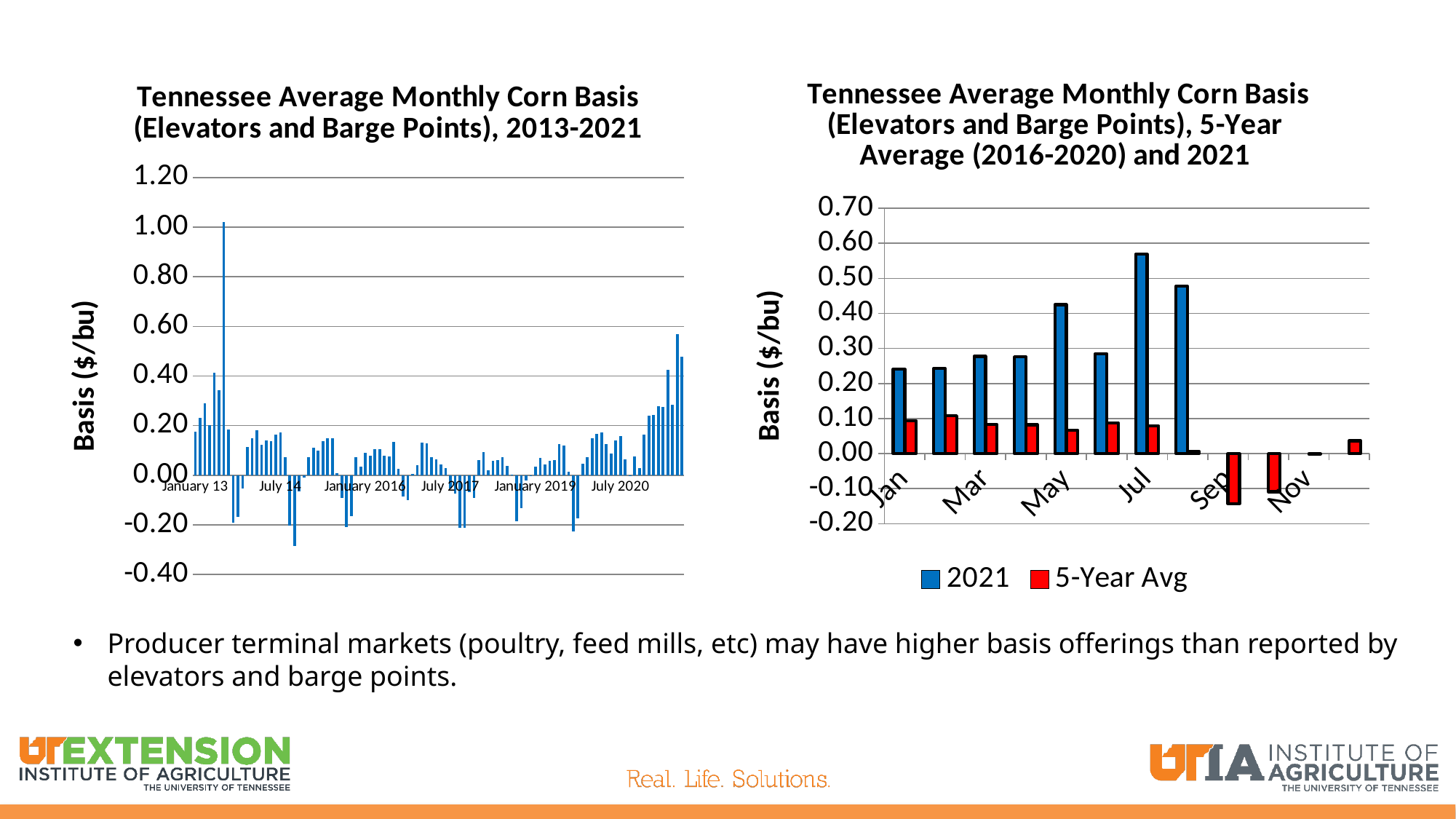
What is the y-axis label of the left-hand chart? Basis ($/bu) In the right-hand chart, is the 2021 basis for Jan greater or less than 0.20? greater In the right-hand chart, which month has the highest 2021 basis? Jul How many series does the legend of the right-hand chart list? 2 In the right-hand chart, is the 2021 basis for Jul greater or less than 0.50? greater In the right-hand chart, which month has the lowest 5-Year Avg basis? Sep What kind of chart is the right-hand chart titled 'Tennessee Average Monthly Corn Basis (Elevators and Barge Points), 5-Year Average (2016-2020) and 2021'? Bar chart In the right-hand chart, for Jul, which is larger: the 2021 basis or the 5-Year Avg basis? 2021 In the right-hand chart, is the 5-Year Avg basis for Sep greater or less than -0.10? less In the right-hand chart, which series is shown in red? 5-Year Avg What kind of chart is the left-hand chart titled 'Tennessee Average Monthly Corn Basis (Elevators and Barge Points), 2013-2021'? Bar chart